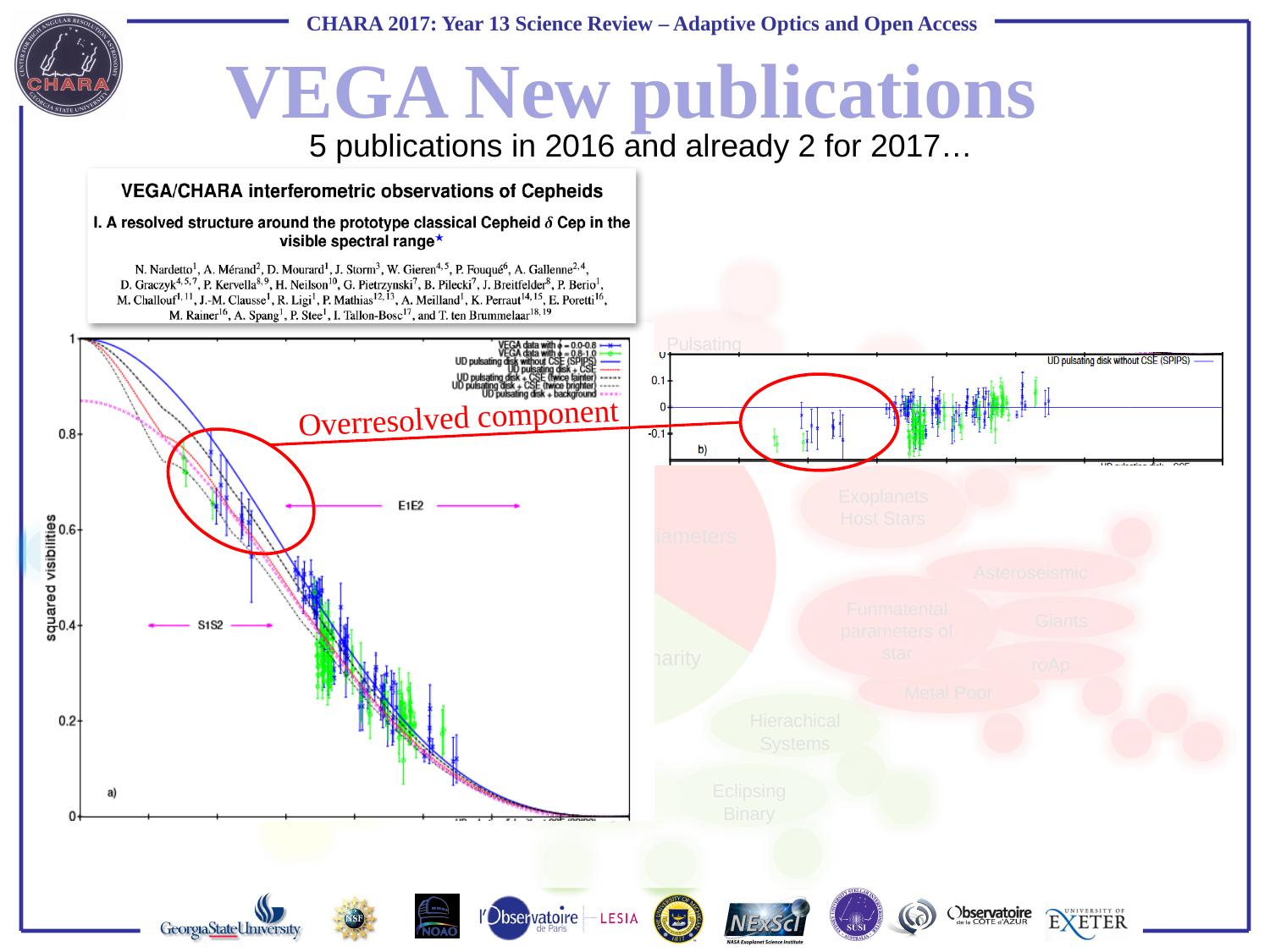
Which baseline, S1S2 or E1E2, is located at higher values along the x axis in panel a? E1E2 Do the squared visibilities rise or fall as you move along the x axis in panel a? Fall Which model curve is named in the legend of the residual panel (b)? UD pulsating disk without CSE (SPIPS) What kind of chart is the main panel (a) on the slide? Scatter plot with error bars and model curves What is the label of the y axis of the main plot (panel a)? squared visibilities What are the tick values shown on the y axis of the residual panel (b)? -0.1, 0, 0.1 What text annotation points to the red-circled data points in panel a? Overresolved component What is the highest tick value shown on the y axis of panel a? 1 Are the squared visibilities of the data points in the S1S2 range greater or less than 0.4? greater Which two baseline labels are marked with horizontal arrows in panel a? S1S2 and E1E2 How many entries does the legend of the main plot (panel a) list? 7 How many panels does the plot on the slide have? 2